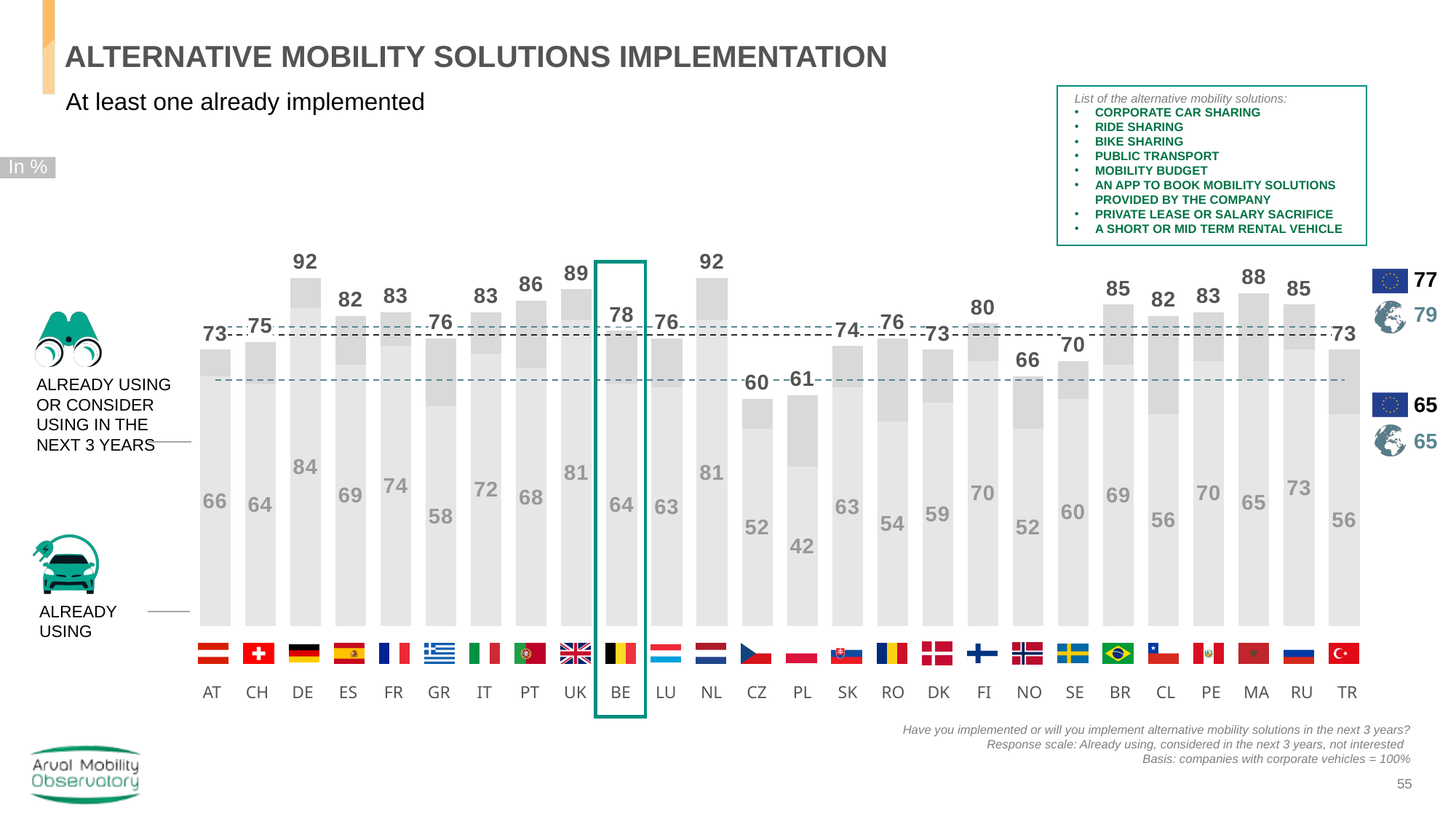
Which has a higher 'already using' value, UK or FR? UK What is the 'already using or consider using in the next 3 years' value for Belgium (BE)? 78 Which country has the highest 'already using' value? DE What kind of chart is used on this slide? Bar chart What is the EU average for 'already using' shown at the right of the chart? 65 What is the global average for 'already using or consider using in the next 3 years' shown at the right of the chart? 79 How many countries are shown on the x axis of the chart? 26 Which country has the lowest 'already using' value? PL What is the difference between the 'already using or consider using' value and the 'already using' value for Greece (GR)? 18 What is the 'already using' value for Poland (PL)? 42 Which country has the lowest 'already using or consider using in the next 3 years' value? CZ Which country's bar is highlighted with a green outline on the chart? BE